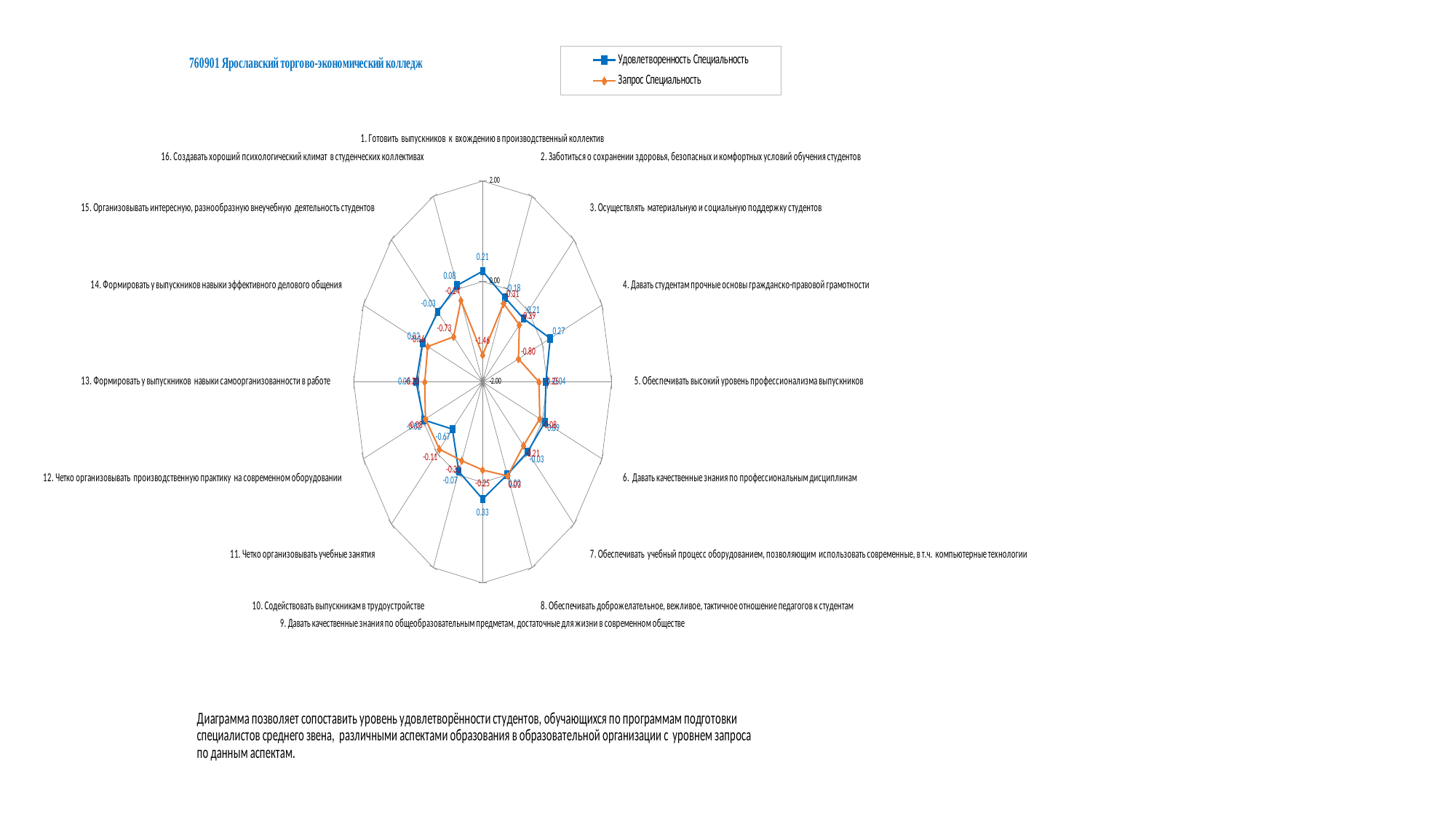
What is the value of the 'Удовлетворенность Специальность' series for category 1 (Готовить выпускников к вхождению в производственный коллектив)? 0.21 What is the value of the 'Запрос Специальность' series for category 1 (Готовить выпускников к вхождению в производственный коллектив)? -1.46 What is the difference between the 'Удовлетворенность Специальность' value (0.21) and the 'Запрос Специальность' value (-1.46) for category 1? 1.67 Which category has the lowest value in the 'Запрос Специальность' series? 1. Готовить выпускников к вхождению в производственный коллектив What is the value of the 'Запрос Специальность' series for category 15 (Организовывать интересную, разнообразную внеучебную деятельность студентов)? -0.73 What is the title shown above the chart? 760901 Ярославский торгово-экономический колледж What is the value of the 'Удовлетворенность Специальность' series for category 9 (Давать качественные знания по общеобразовательным предметам)? 0.33 How many categories (aspects) are plotted on the radar chart? 16 What kind of chart is shown on the slide? Radar chart Which category has the highest value in the 'Удовлетворенность Специальность' series? 9. Давать качественные знания по общеобразовательным предметам, достаточные для жизни в современном обществе What is the value of the 'Запрос Специальность' series for category 4 (Давать студентам прочные основы гражданско-правовой грамотности)? -0.80 How many series does the legend list? 2